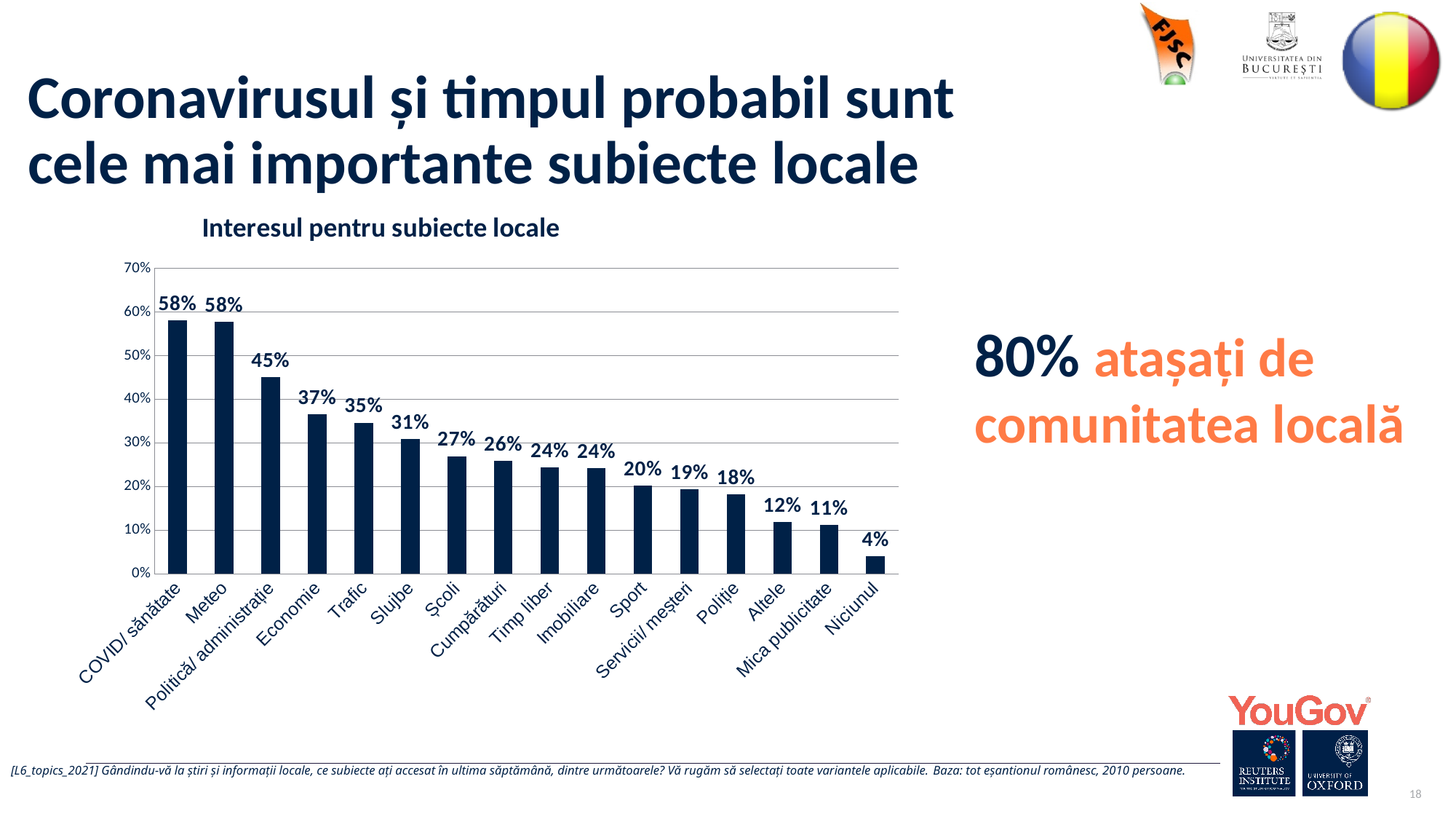
What is the value for Sport? 20% What is the value for Politică/ administrație? 45% What is the difference between the values for Meteo and Poliție? 40% What is the value for Mica publicitate? 11% What is the title of the chart? Interesul pentru subiecte locale What is the difference between the values for Economie and Trafic? 2% How many categories are shown on the x axis? 16 Which is larger, the value for Școli or the value for Imobiliare? Școli Which category has the lowest value? Niciunul Is the value for Cumpărături greater or less than 30%? less What kind of chart is shown on the slide? bar chart What is the value for Slujbe? 31%